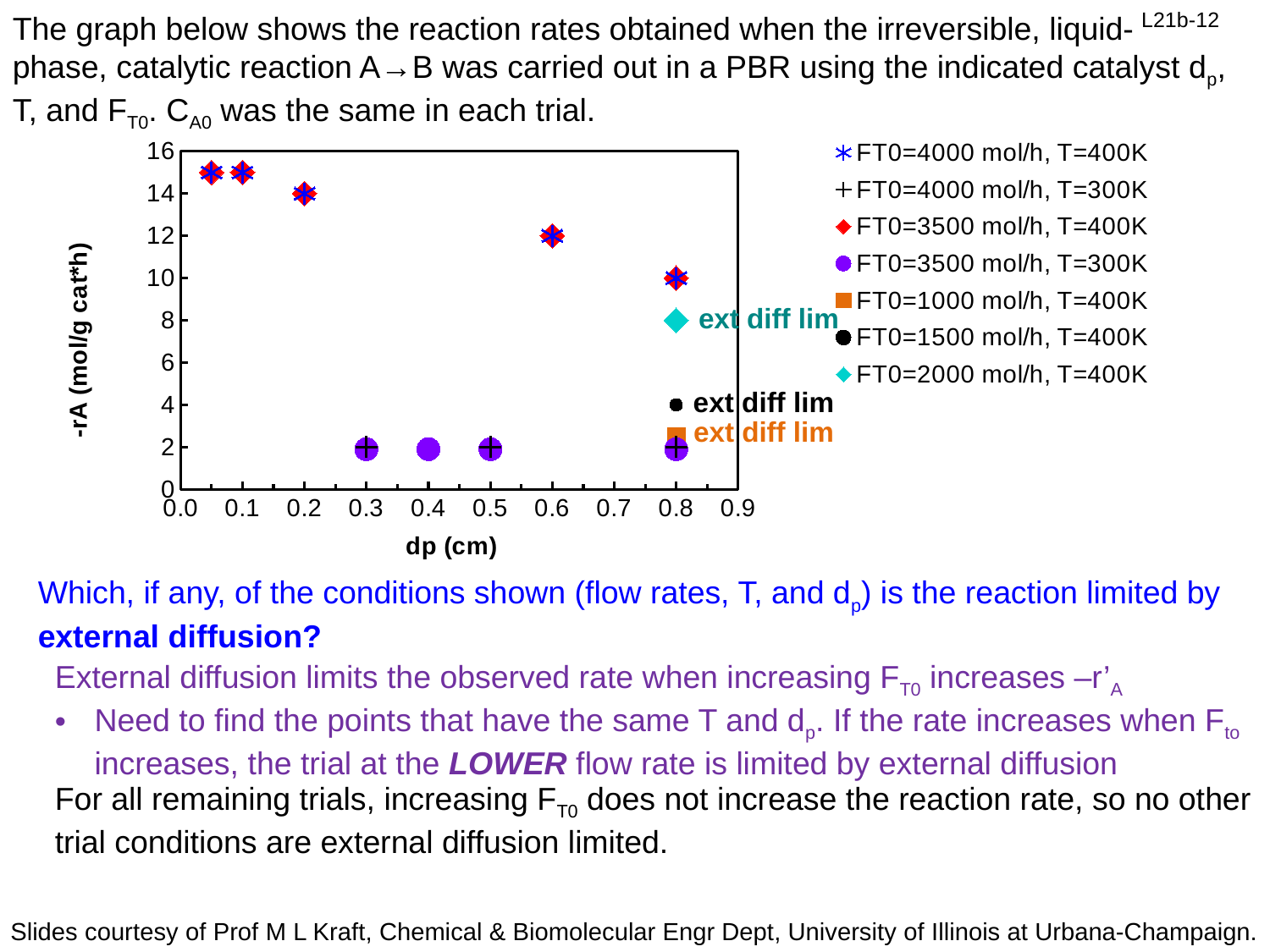
At dp = 0.8 cm, which series has the higher reaction rate: FT0=2000 mol/h, T=400K or FT0=1500 mol/h, T=400K? FT0=2000 mol/h, T=400K How many series does the legend list? 7 What is the reaction rate for the FT0=2000 mol/h, T=400K series (cyan diamond) at dp = 0.8 cm? 8 What kind of chart is shown on the slide? scatter plot For the T=400K series at FT0=4000 mol/h, does the reaction rate rise or fall as dp increases? fall What is the reaction rate for the FT0=4000 mol/h, T=400K series at dp = 0.6 cm? 12 Is the reaction rate for the FT0=1000 mol/h, T=400K series at dp = 0.8 cm greater or less than 4? less Is the reaction rate for the FT0=4000 mol/h, T=400K series at dp = 0.1 cm greater or less than 14? greater What is the label of the x axis? dp (cm) What is the label of the y axis? -rA (mol/g cat*h) What is the reaction rate for the FT0=1500 mol/h, T=400K series (black circle) at dp = 0.8 cm? 4